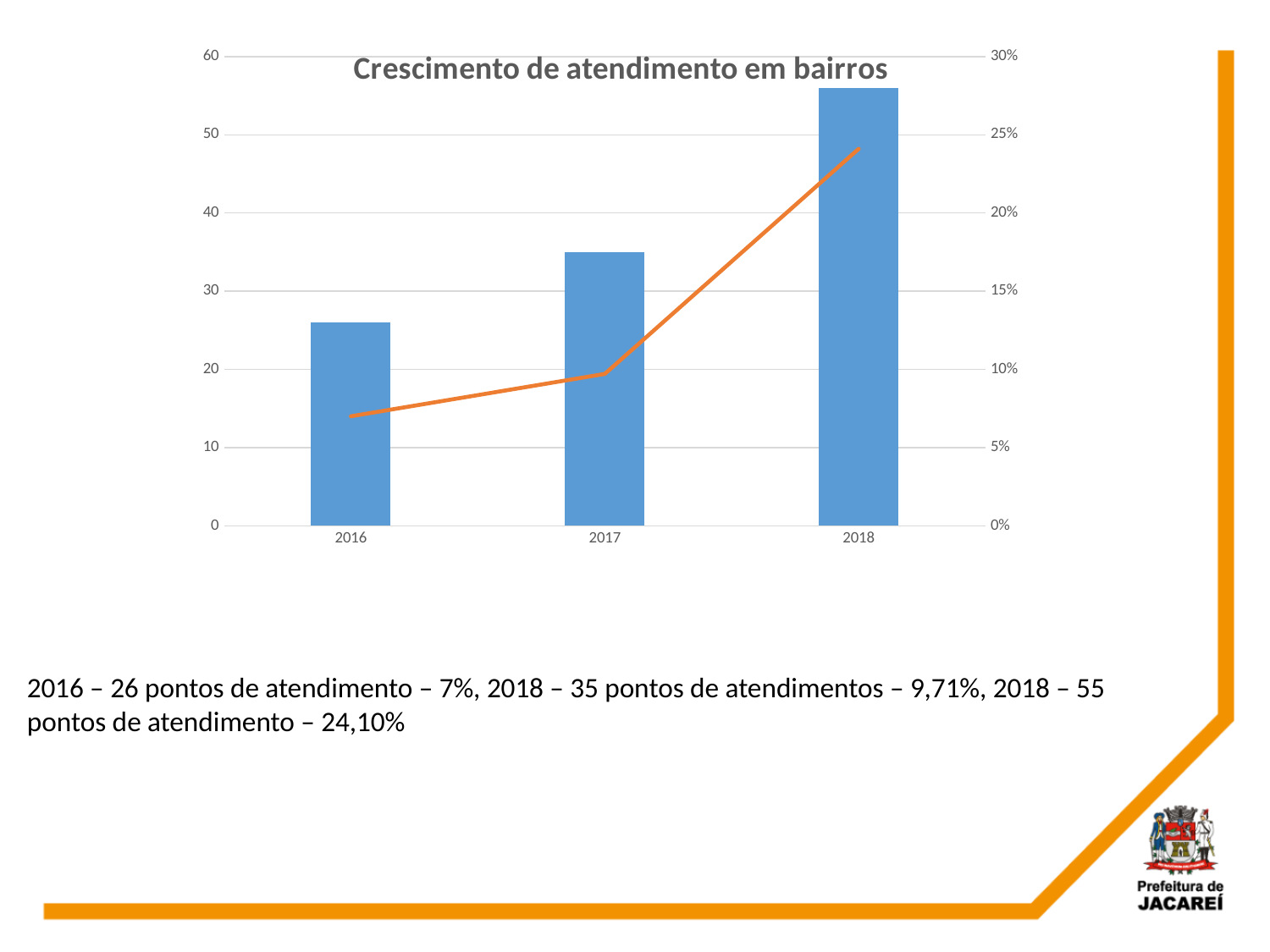
How many years are shown on the x axis of the chart? 3 What percentage is given for 2018? 24,10% What kind of chart is shown on the slide? bar chart with a line How many pontos de atendimento are shown for 2018? 55 Is the bar value for 2017 greater or less than 30? greater Do the bar values rise or fall from 2016 to 2018? rise Which year has the tallest bar in the chart? 2018 Is the line value for 2018 greater or less than 20%? greater Which year has the shortest bar in the chart? 2016 How many pontos de atendimento are shown for 2016? 26 What percentage is given for 2016? 7% What is the difference in pontos de atendimento between 2018 and 2016? 29